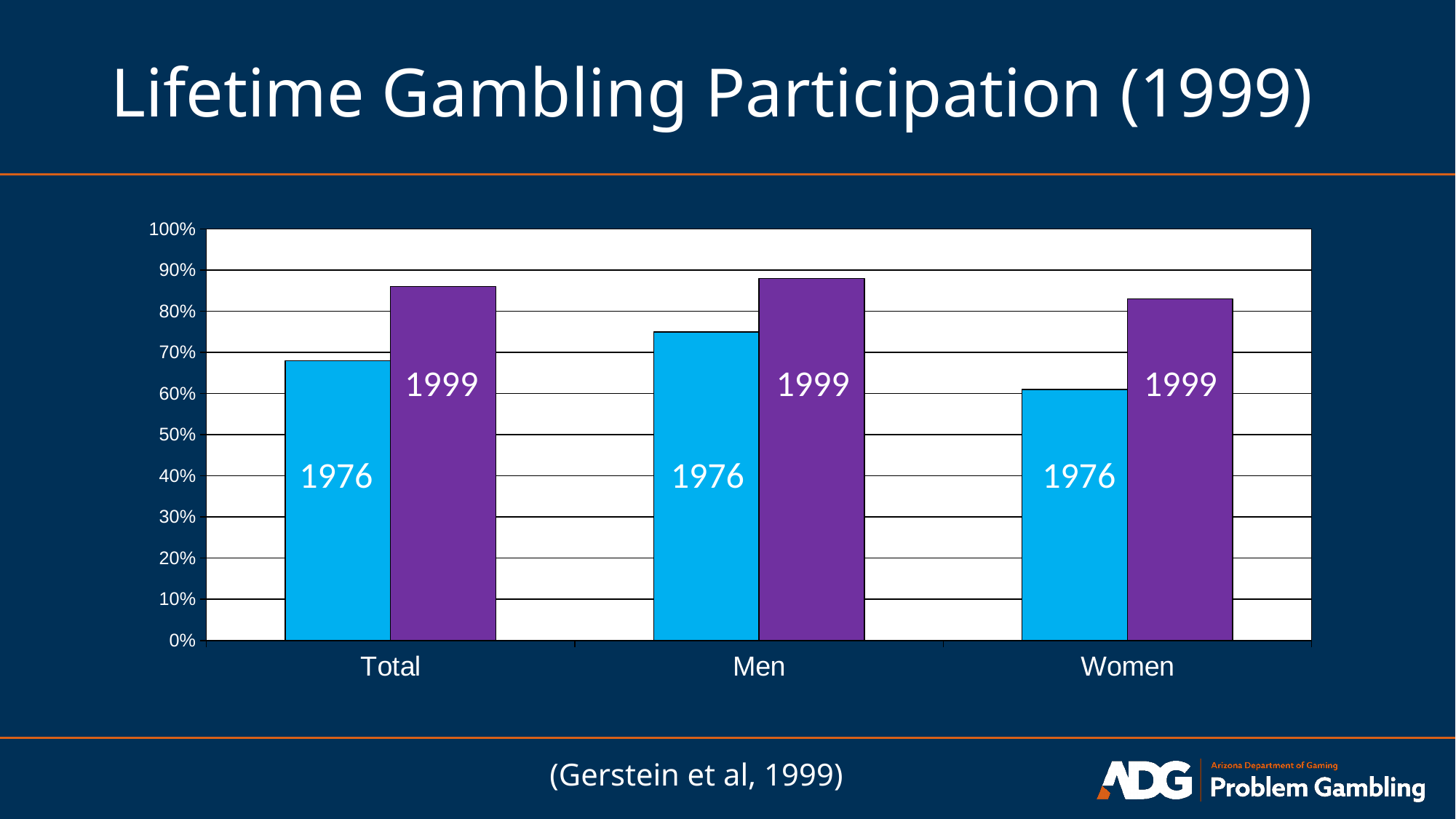
Which two years are compared by the bars in the chart? 1976 and 1999 Is the 1976 value for Women greater or less than 70%? less What kind of chart is shown on the slide? bar chart Is the 1976 value for Men greater or less than 70%? greater For Women, which year has the larger value, 1976 or 1999? 1999 Among the 1976 bars, which category has the highest value? Men Is the 1976 value for Total greater or less than 70%? less What is the title of the slide containing the chart? Lifetime Gambling Participation (1999) How many categories are shown on the x axis of the chart? 3 Among the 1976 bars, which category has the lowest value? Women